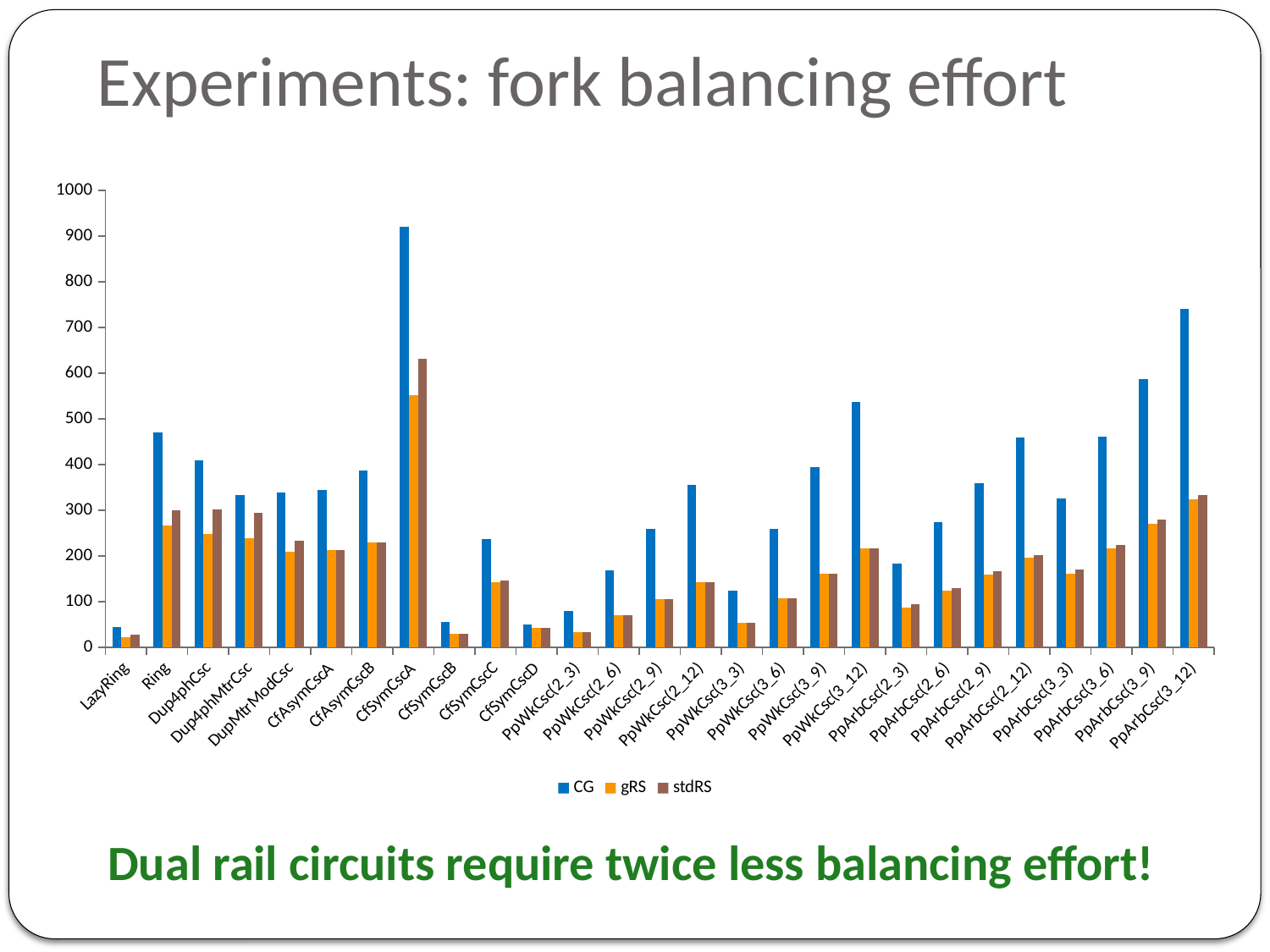
How many series does the legend list? 3 Is the CG value for Ring greater or less than 500? less Is the CG value for CfSymCscA greater or less than 800? greater What are the three series named in the legend? CG, gRS, stdRS Is the gRS value for CfSymCscA greater or less than 500? greater Which has the larger CG value, CfSymCscA or PpArbCsc(3_12)? CfSymCscA Which category has the highest stdRS value? CfSymCscA How many circuit categories are shown along the x axis? 27 Which is larger for Ring, the CG value or the gRS value? CG Which category has the highest CG value? CfSymCscA What kind of chart is shown on the slide? bar chart